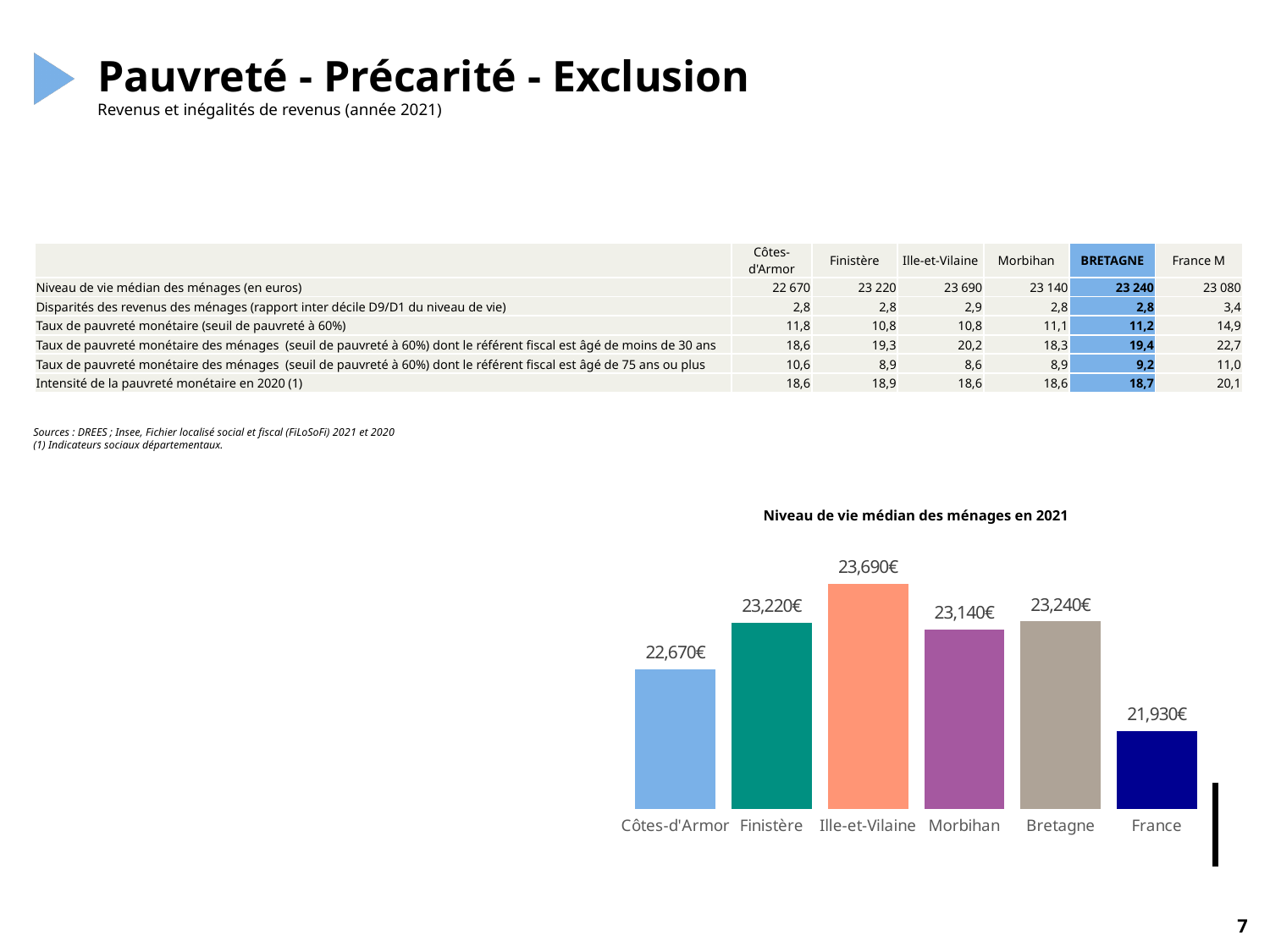
How many categories are plotted in the chart? 6 What is the value shown for Côtes-d'Armor in the chart? 22,670€ What is the value shown for France in the chart? 21,930€ What is the value shown for Bretagne in the chart? 23,240€ What is the difference between the values for Ille-et-Vilaine and France in the chart? 1,760€ What is the value shown for Ille-et-Vilaine in the chart? 23,690€ Which has a larger value in the chart, Finistère or Morbihan? Finistère What is the title of the chart on the slide? Niveau de vie médian des ménages en 2021 What is the difference between the values for Bretagne and Côtes-d'Armor in the chart? 570€ Which category has the highest value in the chart? Ille-et-Vilaine What kind of chart is shown on the slide? bar chart Which category has the lowest value in the chart? France